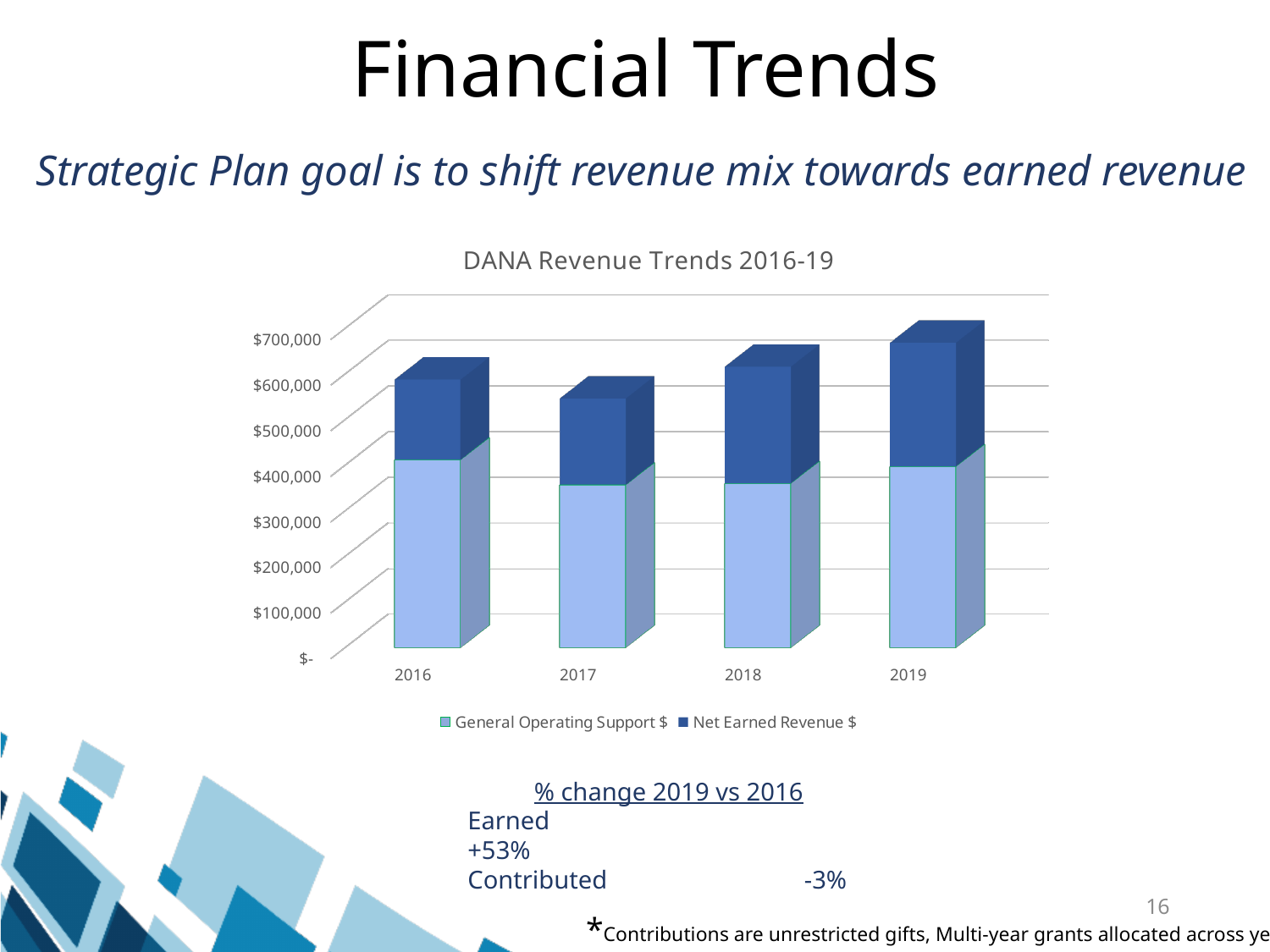
Does the total bar height rise or fall from 2017 to 2019? rise Which year has the larger Net Earned Revenue $ segment, 2016 or 2019? 2019 How many series does the chart legend list? 2 What is the title of the chart? DANA Revenue Trends 2016-19 Which series forms the bottom segment of each stacked bar? General Operating Support $ Which year has the shortest total bar? 2017 Which year has the tallest total bar? 2019 Is the General Operating Support $ value for 2017 greater or less than $300,000? greater What kind of chart is shown on the slide? Stacked bar chart Is the total bar for 2019 greater or less than $600,000? greater Is the total bar for 2016 greater or less than $500,000? greater How many years are shown on the x axis of the chart? 4